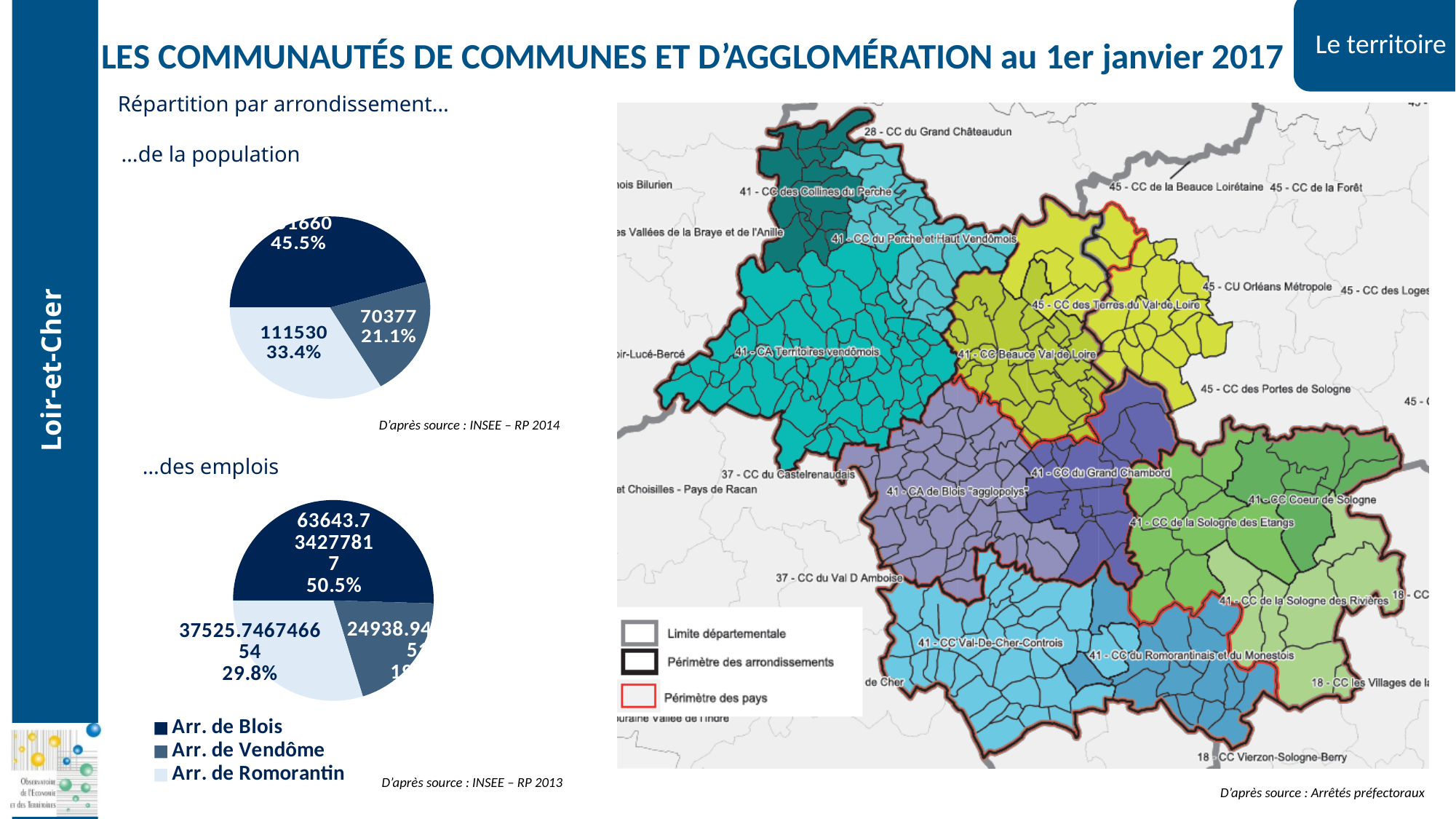
What type of chart is used for the '...des emplois' chart? Pie chart In the '...des emplois' pie chart, what share is shown for Arr. de Blois? 50.5% In the '...de la population' pie chart, what share of the population does Arr. de Vendôme have? 21.1% In the '...de la population' pie chart, which arrondissement has the smallest share? Arr. de Vendôme In the '...de la population' pie chart, which is larger: the value for Arr. de Romorantin or for Arr. de Vendôme? Arr. de Romorantin In the '...des emplois' pie chart, what share is shown for Arr. de Romorantin? 29.8% How many arrondissements does the legend below the pie charts list? 3 In the '...de la population' pie chart, what is the population value shown for Arr. de Romorantin? 111530 In the '...des emplois' pie chart, which arrondissement has the smallest slice? Arr. de Vendôme In the '...de la population' pie chart, what is the difference between the population values of Arr. de Romorantin and Arr. de Vendôme? 41153 In the '...de la population' pie chart, which arrondissement has the largest share? Arr. de Blois